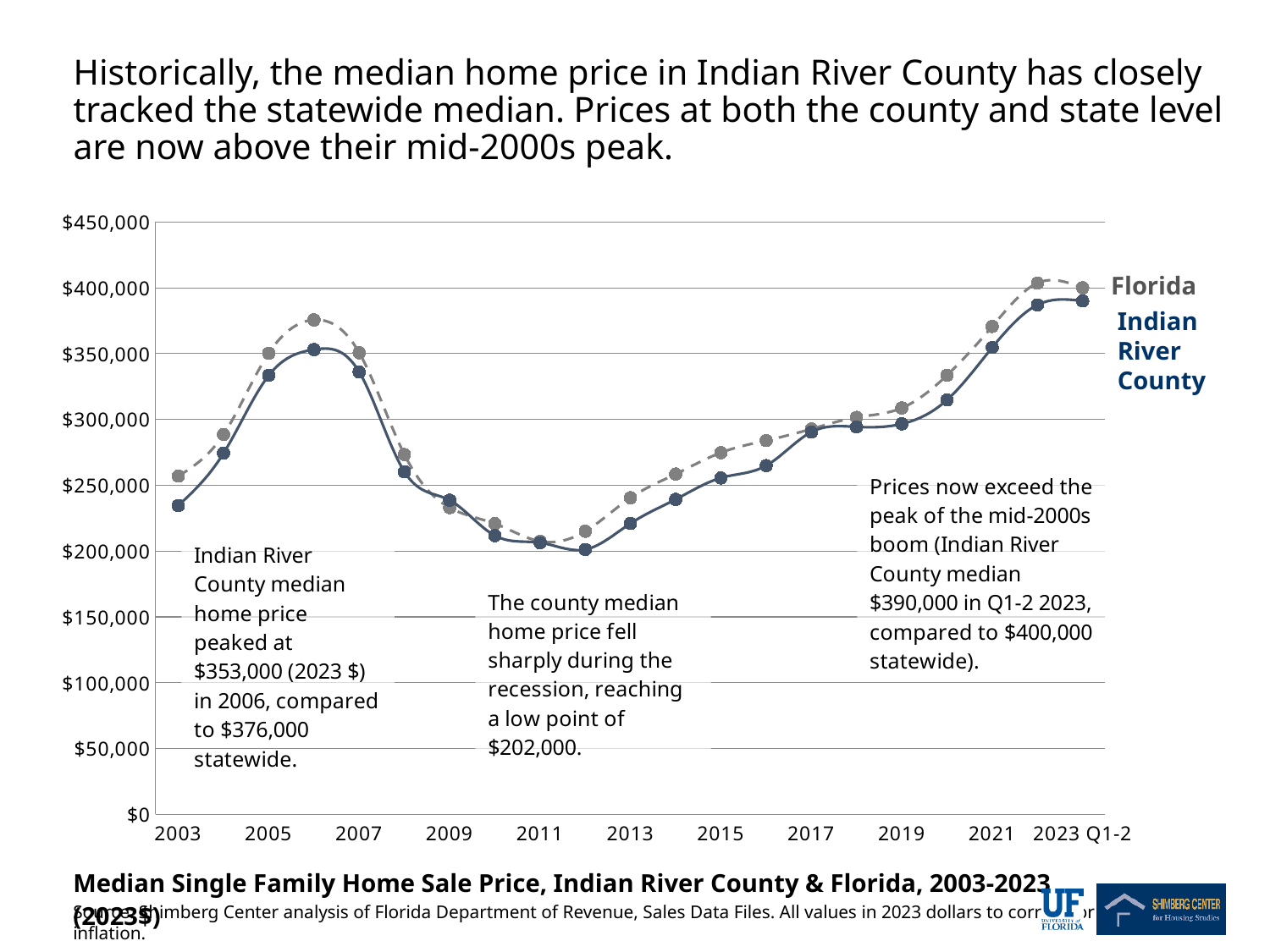
What kind of chart is shown on the slide? Line chart Is the Indian River County median home price in 2003 greater or less than $250,000? less What was the statewide (Florida) median home price in 2006, according to the slide? $376,000 In 2006, how much higher was the Florida median home price than the Indian River County median? $23,000 What was the Indian River County median home price at its 2006 peak, according to the slide? $353,000 What was the low point of the Indian River County median home price during the recession? $202,000 In Q1-2 2023, what is the difference between the Florida median ($400,000) and the Indian River County median ($390,000)? $10,000 In 2006, which series had the higher median home price, Florida or Indian River County? Florida What was the Indian River County median home price in Q1-2 2023? $390,000 How many series does the chart plot? 2 Is the Florida median home price in 2021 greater or less than $350,000? greater Does the Indian River County median home price rise or fall between 2012 and 2023 Q1-2? rise